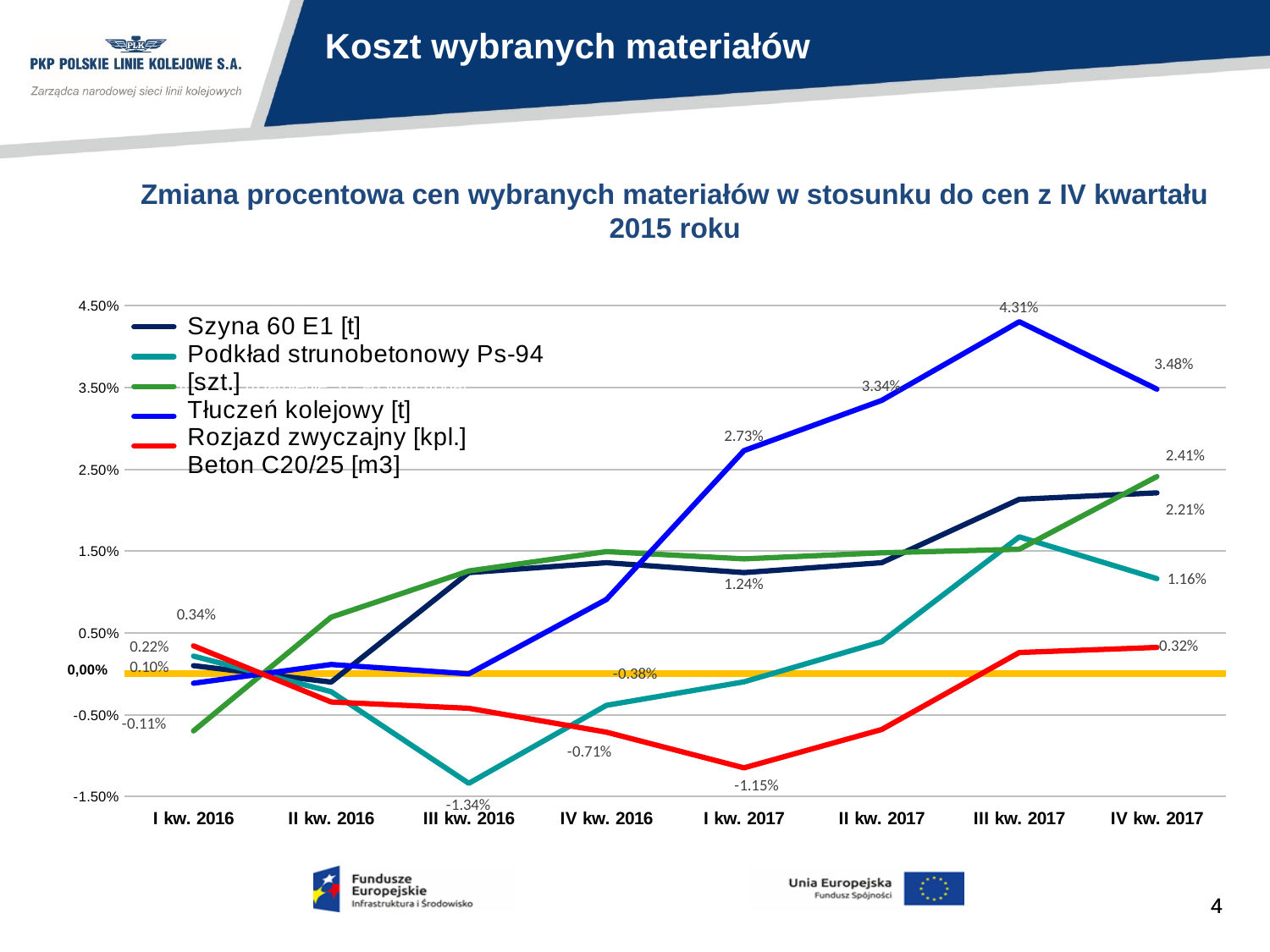
What type of chart is shown on the slide? Line chart Which series reaches the highest value on the chart, and in which quarter? Rozjazd zwyczajny [kpl.], III kw. 2017 What is the value for Rozjazd zwyczajny [kpl.] in IV kw. 2017? 3.48% In IV kw. 2017, which is higher: Beton C20/25 [m3] or Szyna 60 E1 [t]? Szyna 60 E1 [t] What is the value for Beton C20/25 [m3] in IV kw. 2017? 0.32% How many quarters are shown on the x axis of the chart? 8 What is the value for Podkład strunobetonowy Ps-94 [szt.] in III kw. 2016? -1.34% Is the value for Tłuczeń kolejowy [t] in IV kw. 2016 greater or less than 0.50%? greater How many series does the chart legend list? 5